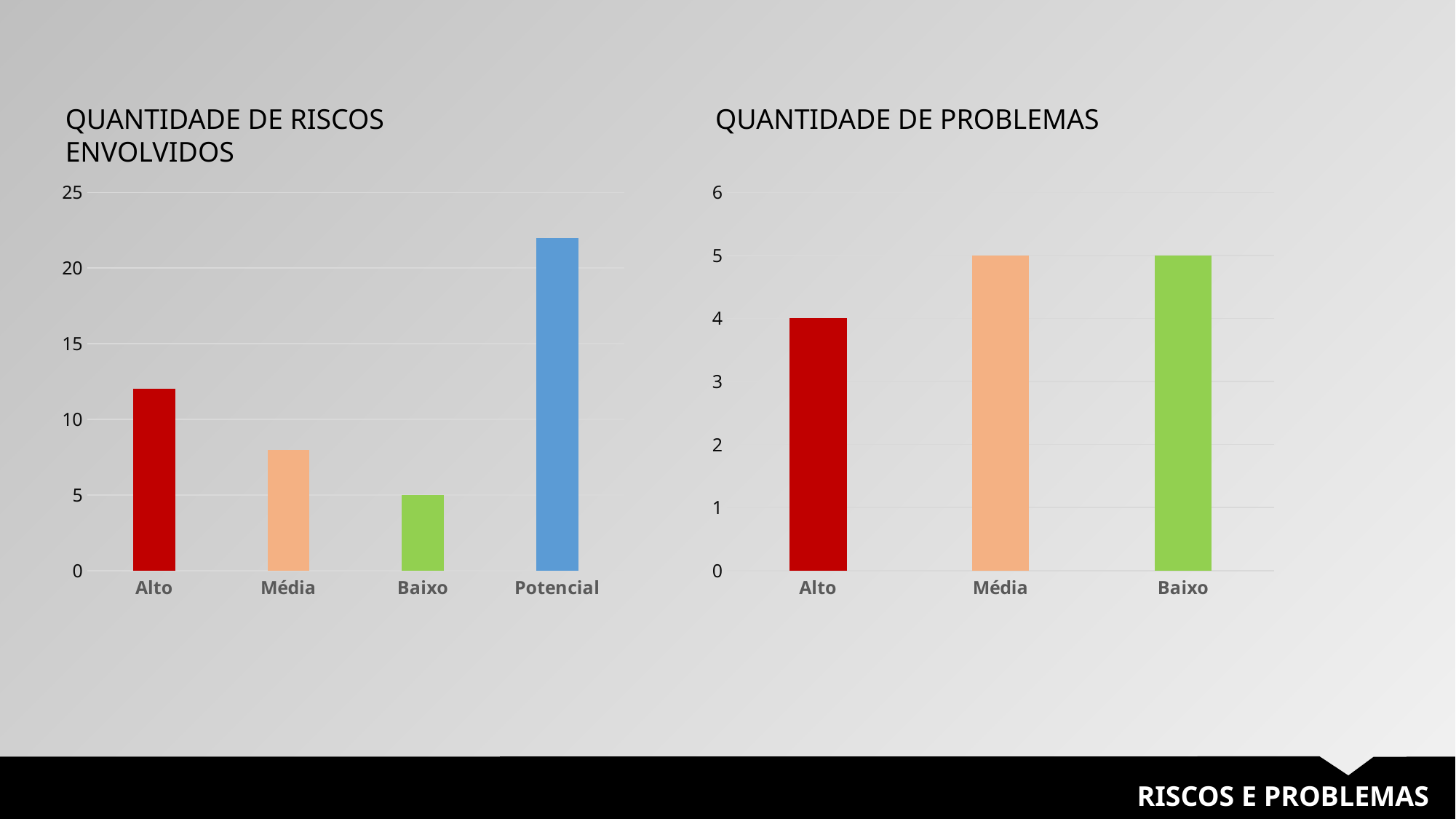
In the chart titled QUANTIDADE DE RISCOS ENVOLVIDOS, is the value for Média greater or less than 10? less In the chart titled QUANTIDADE DE PROBLEMAS, which category has the lowest value? Alto How many categories are shown in the chart titled QUANTIDADE DE RISCOS ENVOLVIDOS? 4 In the chart titled QUANTIDADE DE RISCOS ENVOLVIDOS, which is larger, the value for Alto or the value for Média? Alto In the chart titled QUANTIDADE DE RISCOS ENVOLVIDOS, which category has the highest value? Potencial In the chart titled QUANTIDADE DE PROBLEMAS, what is the value for Média? 5 In the chart titled QUANTIDADE DE PROBLEMAS, what is the value for Alto? 4 In the chart titled QUANTIDADE DE PROBLEMAS, what is the difference between the values for Média and Alto? 1 What kind of chart is the chart titled QUANTIDADE DE PROBLEMAS? bar chart In the chart titled QUANTIDADE DE RISCOS ENVOLVIDOS, which category has the lowest value? Baixo In the chart titled QUANTIDADE DE RISCOS ENVOLVIDOS, is the value for Potencial greater or less than 20? greater In the chart titled QUANTIDADE DE RISCOS ENVOLVIDOS, what is the value for Baixo? 5